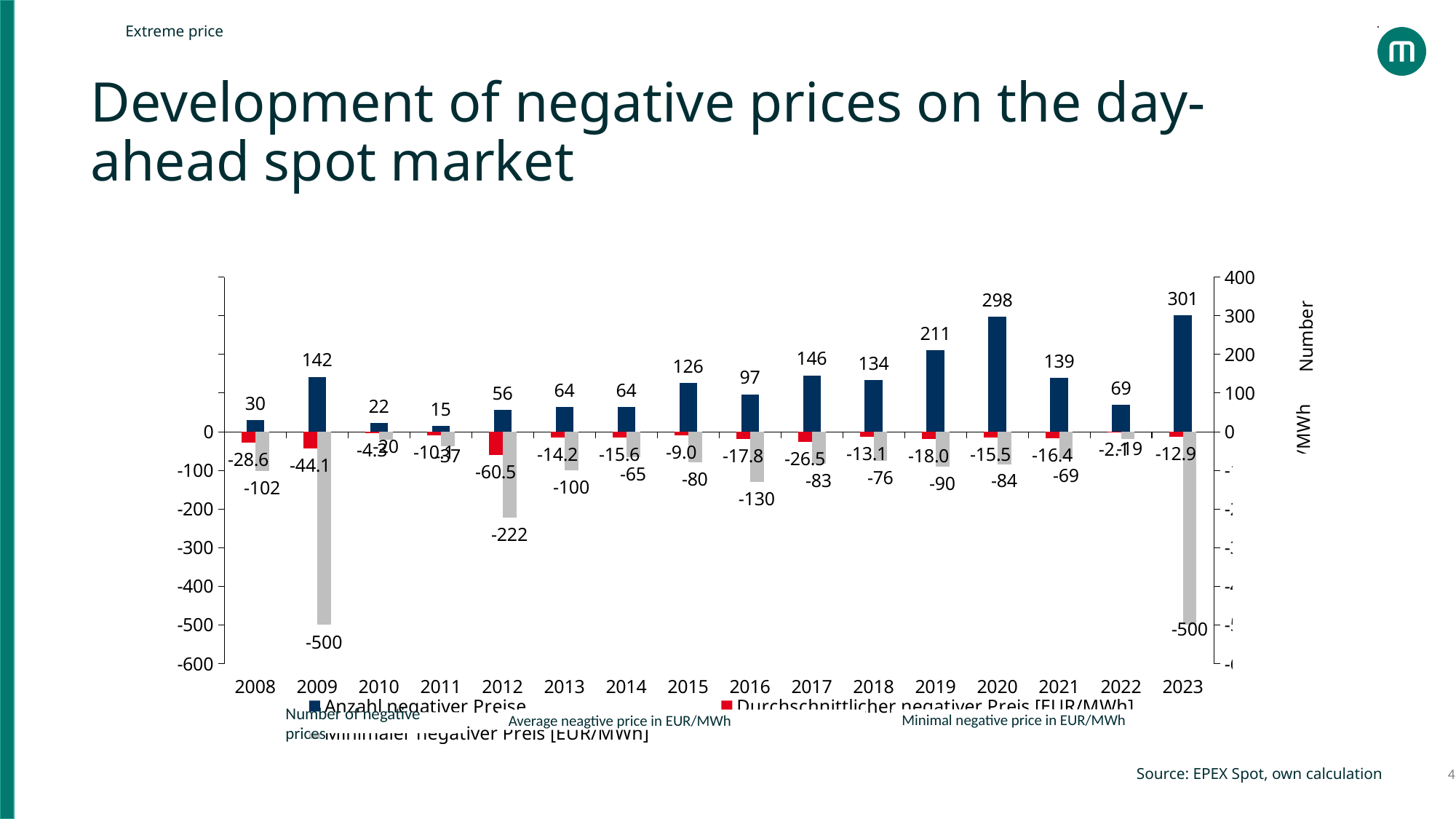
Which year had the highest number of negative prices? 2023 How many series does the legend list? 3 What was the average negative price in EUR/MWh in 2012? -60.5 How many negative prices were recorded in 2020? 298 Which year had more negative prices, 2019 or 2021? 2019 What is the difference between the number of negative prices in 2023 and in 2020? 3 What was the minimal negative price in EUR/MWh in 2016? -130 Which year had the lowest number of negative prices? 2011 How many years are shown on the x axis? 16 Which year had the lowest (most negative) average negative price? 2012 What kind of chart is shown on the slide? Bar chart What is the source given for the chart? EPEX Spot, own calculation